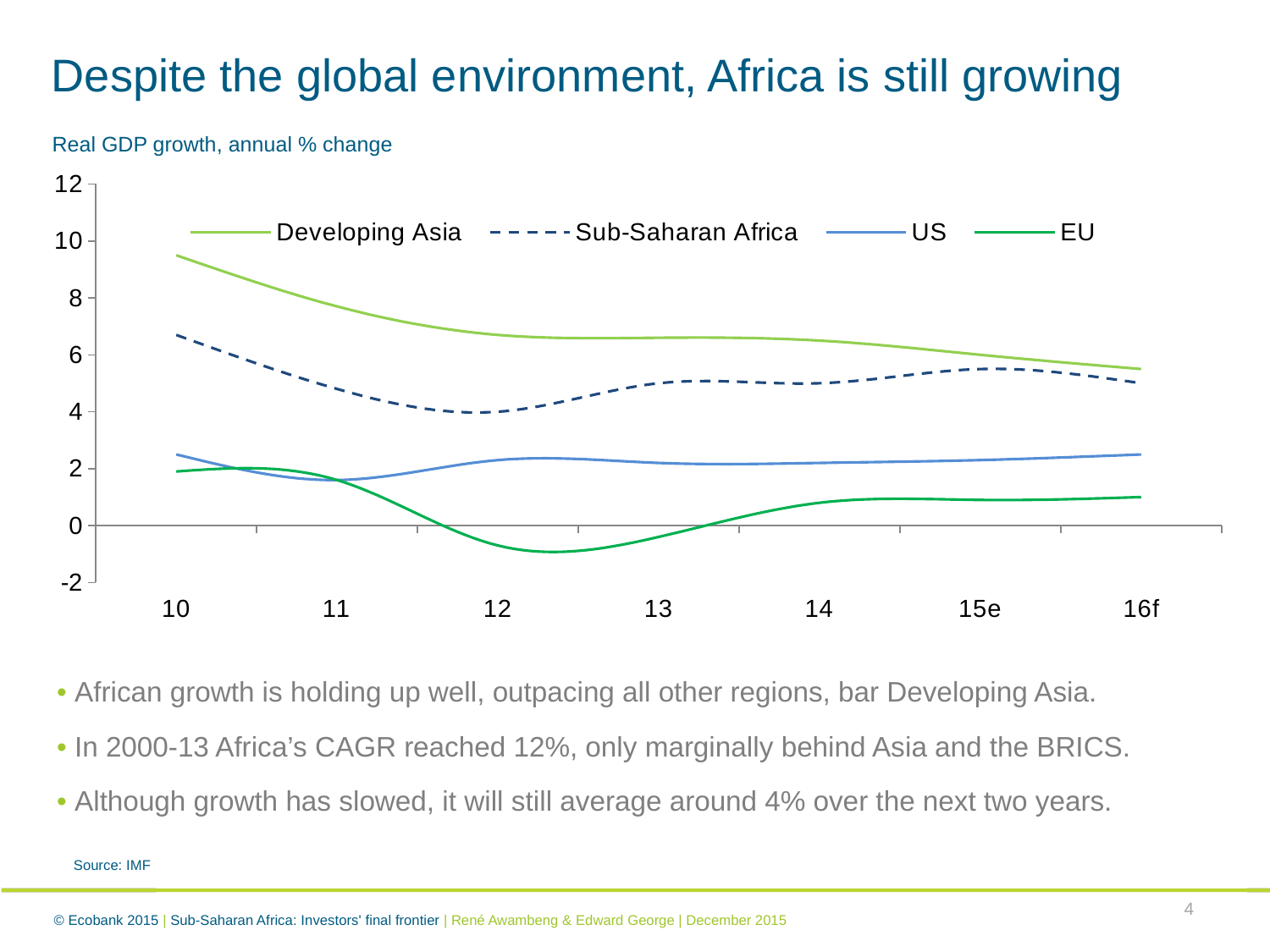
Is the value for Developing Asia in 10 greater or less than 8? greater What is the subtitle describing the chart's measure? Real GDP growth, annual % change Which series is drawn with a dashed line? Sub-Saharan Africa How many points are shown along the x axis? 7 Does the Developing Asia line rise or fall from 10 to 16f? fall How many series does the legend list? 4 Is the value for US in 16f greater or less than 4? less Which series has the lowest value in 12? EU Is the value for Sub-Saharan Africa in 10 greater or less than 6? greater What kind of chart is shown on the slide? line chart Which series has the highest value in 10? Developing Asia Which is larger in 14, Sub-Saharan Africa or US? Sub-Saharan Africa